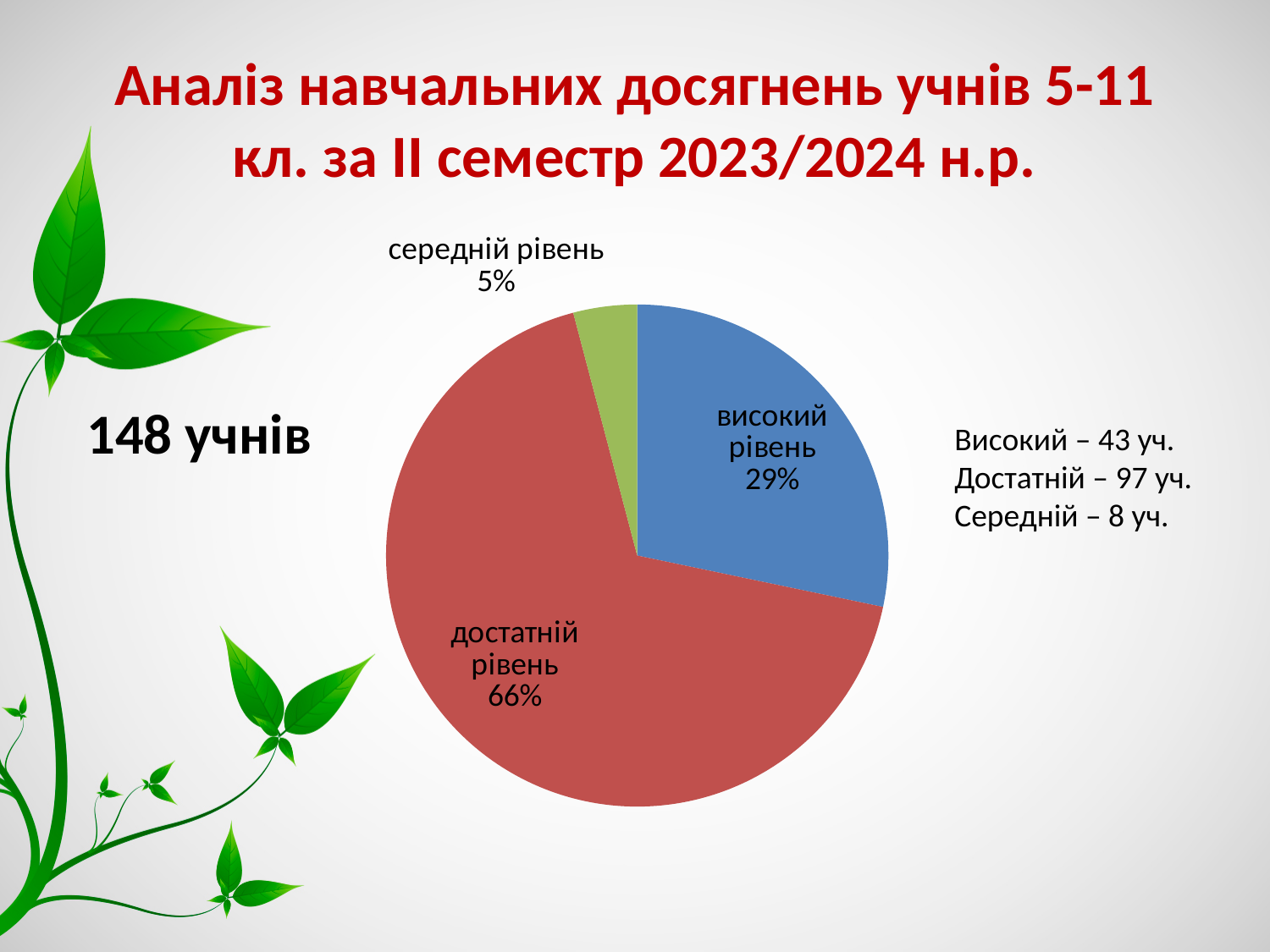
What is the difference in percentage points between "достатній рівень" and "високий рівень"? 37 What colour is the slice for "високий рівень"? blue Which slice is larger, "високий рівень" or "середній рівень"? високий рівень What kind of chart is shown on the slide? pie chart What share of the pie does "високий рівень" represent? 29% Which category has the smallest slice of the pie? середній рівень What is the difference in percentage points between "високий рівень" and "середній рівень"? 24 What colour is the slice for "достатній рівень"? red How many slices does the pie chart have? 3 What share of the pie does "достатній рівень" represent? 66% What share of the pie does "середній рівень" represent? 5% Which category has the largest slice of the pie? достатній рівень